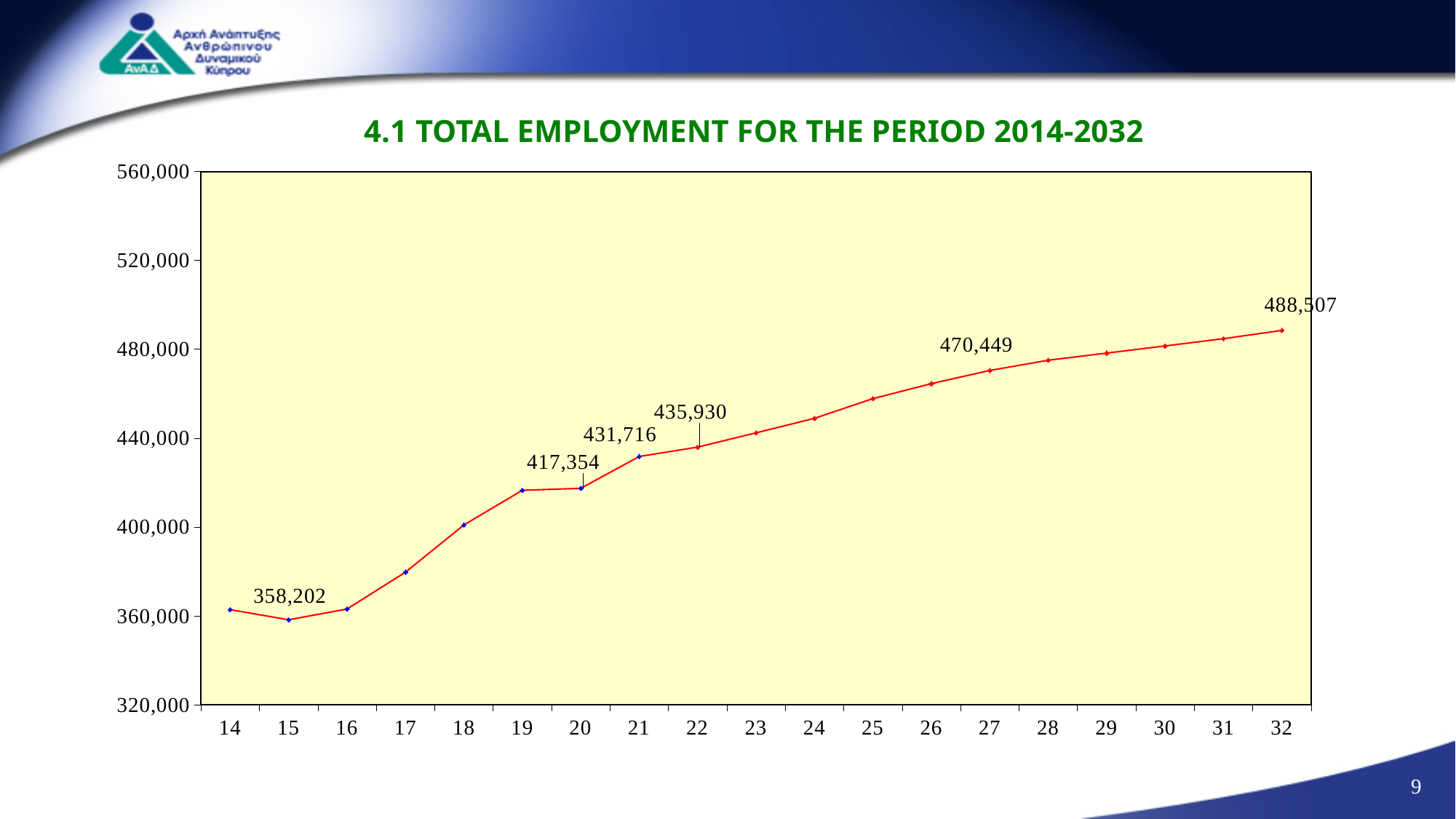
What is the total employment value labelled for year 22? 435,930 What is the total employment value labelled for year 27? 470,449 Which year has the lowest total employment? 15 What is the title of the chart? 4.1 TOTAL EMPLOYMENT FOR THE PERIOD 2014-2032 What is the total employment value labelled for year 15? 358,202 What is the total employment value labelled for year 21? 431,716 What is the total employment value labelled for year 32? 488,507 What type of chart is shown on the slide? line chart What is the difference between the labelled values for year 32 and year 27? 18,058 What is the total employment value labelled for year 20? 417,354 How many years (data points) are plotted on the x axis? 19 Which year has the highest total employment? 32